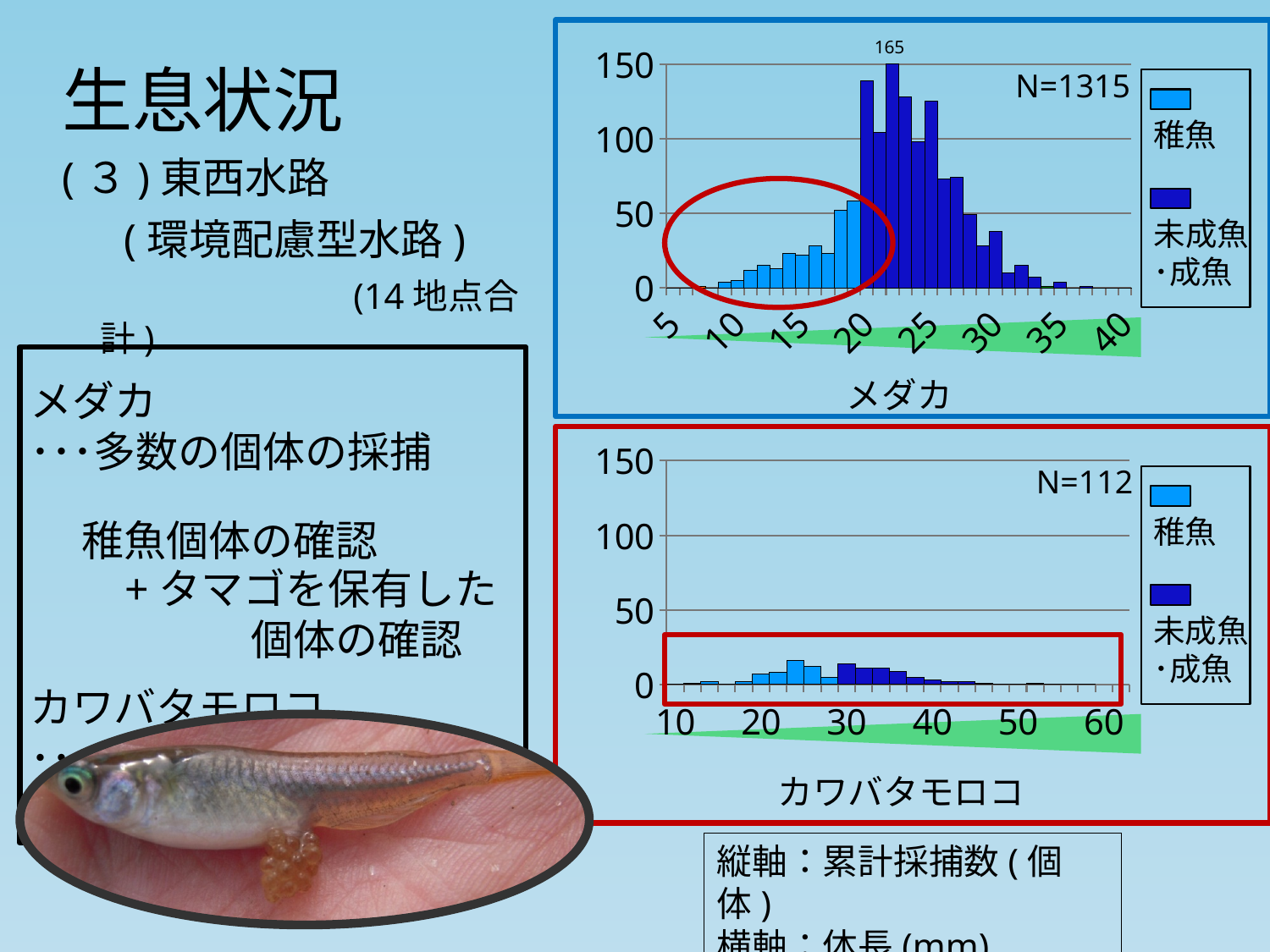
What N value is printed on the カワバタモロコ chart? N=112 Which chart has the larger maximum bar, メダカ or カワバタモロコ? メダカ In the メダカ chart, which series does the tallest bar belong to? 未成魚・成魚 In the メダカ chart, do the dark-blue bars rise or fall as body length goes from 25 to 35? fall What N value is printed on the メダカ chart? N=1315 In the メダカ chart, is the tallest light-blue (稚魚) bar greater or less than 100? less In the カワバタモロコ chart, is the tallest bar greater or less than 50? less How many charts are shown on the slide? 2 How many series does the legend of the メダカ chart list? 2 In the メダカ chart, what value is printed above the tallest bar? 165 In the メダカ chart, is the highest bar greater or less than 150? greater What kind of chart is the メダカ chart at the top right of the slide? bar chart